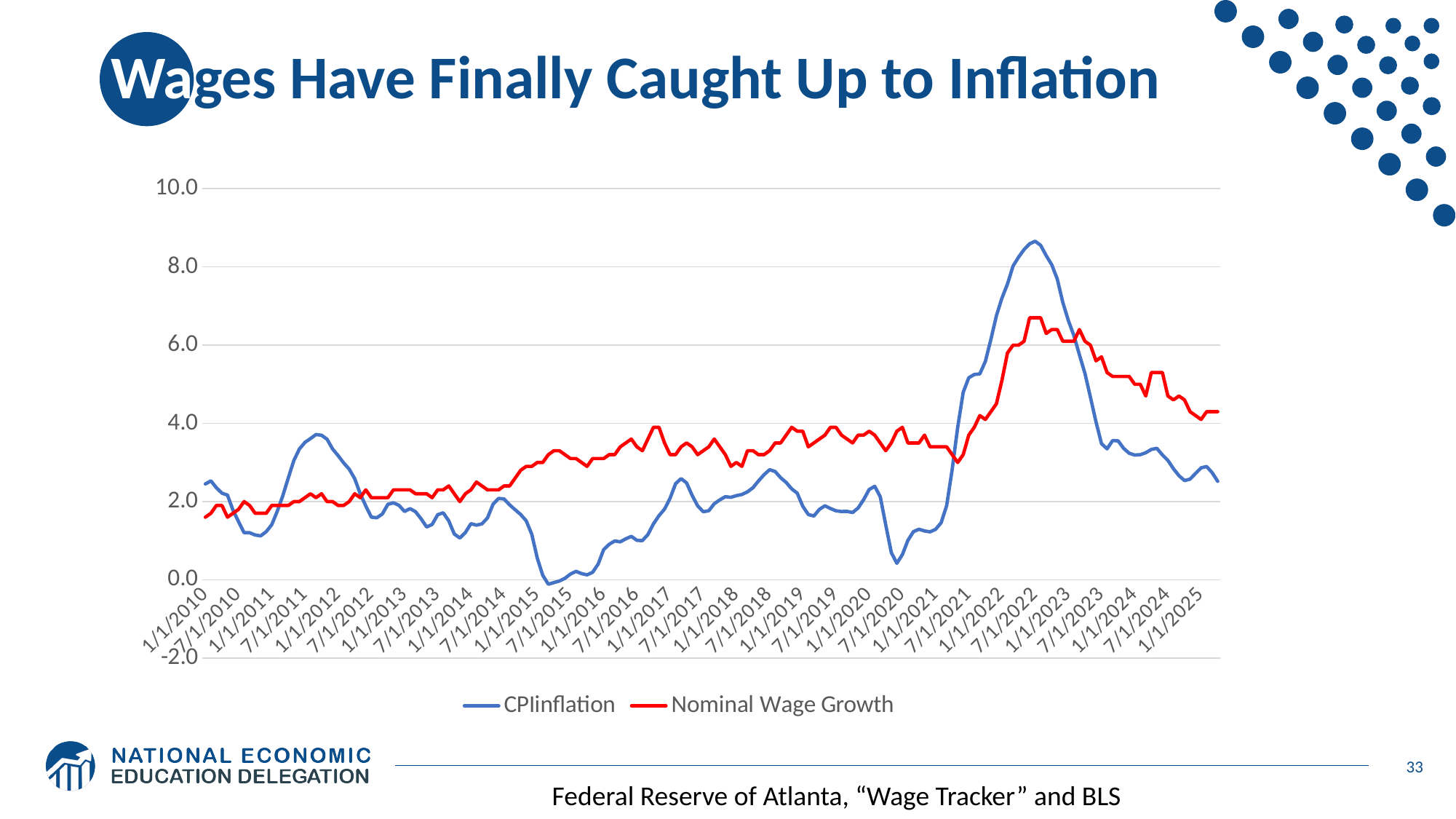
At 1/1/2025, which series has the higher value, CPI inflation or Nominal Wage Growth? Nominal Wage Growth Is the peak value of CPI inflation around 7/1/2022 greater or less than 8.0? greater What is the title of the slide containing the chart? Wages Have Finally Caught Up to Inflation At 7/1/2022, which series has the higher value, CPI inflation or Nominal Wage Growth? CPI inflation What kind of chart is shown on the slide? Line chart How many series does the legend list? 2 Does CPI inflation rise or fall between 7/1/2022 and 7/1/2023? Fall Is the peak value of Nominal Wage Growth in 2022 greater or less than 8.0? less Which series reaches the highest value anywhere on the chart? CPI inflation Which series is drawn in red? Nominal Wage Growth Is the value of CPI inflation at 7/1/2015 greater or less than 2.0? less